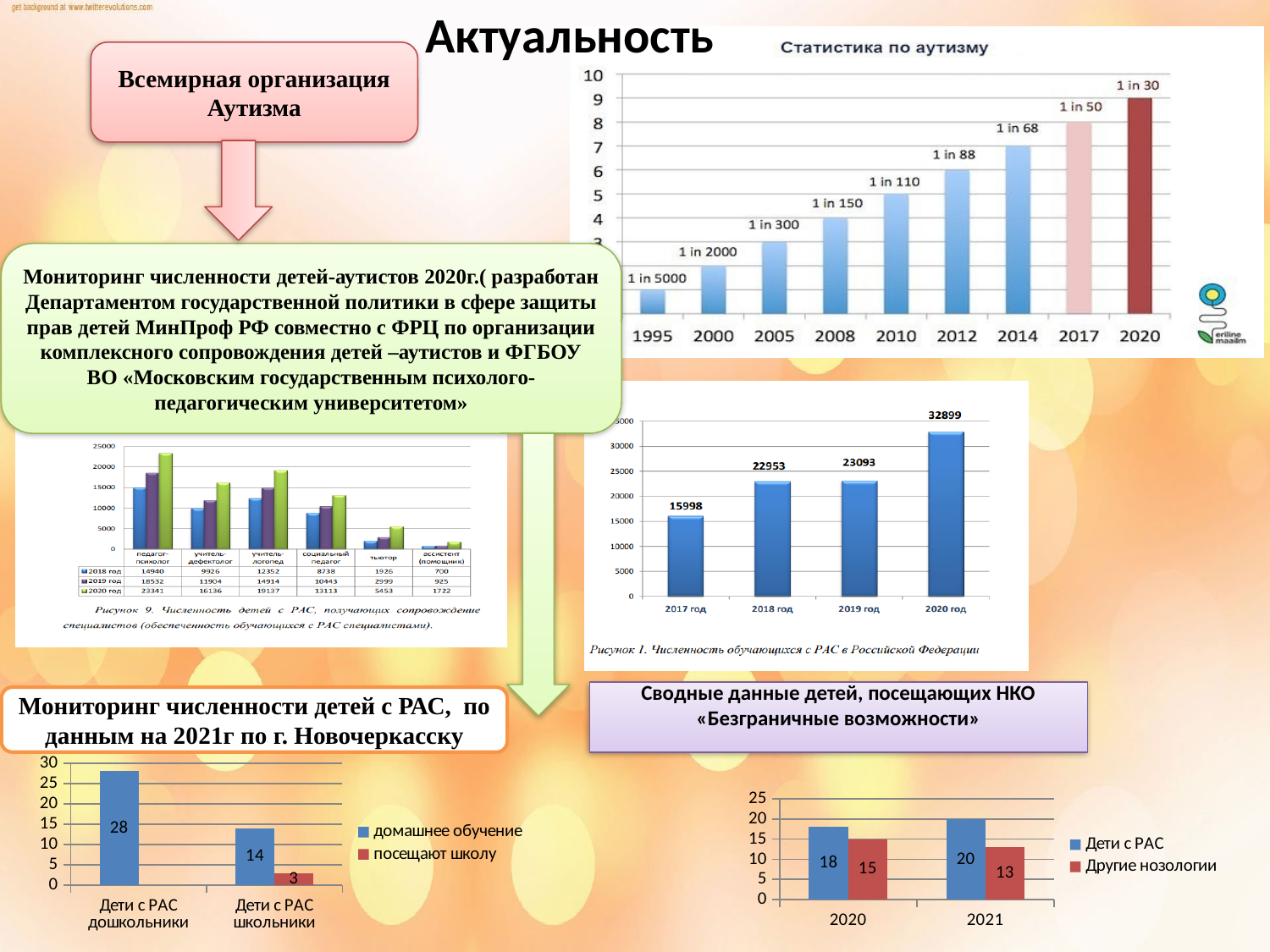
In the chart 'Рисунок 1. Численность обучающихся с РАС в Российской Федерации', do the values rise or fall from 2017 год to 2020 год? rise In the chart 'Рисунок 9' (Численность детей с РАС, получающих сопровождение специалистов), what is the value for 'педагог-психолог' in 2020 год? 23341 In the chart 'Рисунок 1. Численность обучающихся с РАС в Российской Федерации', which year has the lowest value? 2017 год In the chart 'Рисунок 1. Численность обучающихся с РАС в Российской Федерации', what is the value for 2020 год? 32899 In the chart 'Статистика по аутизму' at the top right, what label is shown for the year 2020? 1 in 30 In the bottom-left chart about Novocherkassk, what is the value of 'посещают школу' for 'Дети с РАС школьники'? 3 In the chart 'Рисунок 1. Численность обучающихся с РАС в Российской Федерации', what is the difference between the values for 2020 год and 2019 год? 9806 In the bottom-right chart (Сводные данные детей, посещающих НКО «Безграничные возможности»), what is the difference between 'Дети с РАС' and 'Другие нозологии' in 2021? 7 How many series does the legend of the bottom-left chart about Novocherkassk list? 2 In the bottom-left chart about Novocherkassk (Мониторинг численности детей с РАС по г. Новочеркасску), what is the value of 'домашнее обучение' for 'Дети с РАС дошкольники'? 28 In the bottom-right chart (Сводные данные детей, посещающих НКО «Безграничные возможности»), what is the value of 'Дети с РАС' for 2021? 20 In the bottom-right chart (Сводные данные детей, посещающих НКО «Безграничные возможности»), which is larger in 2020: 'Дети с РАС' or 'Другие нозологии'? Дети с РАС